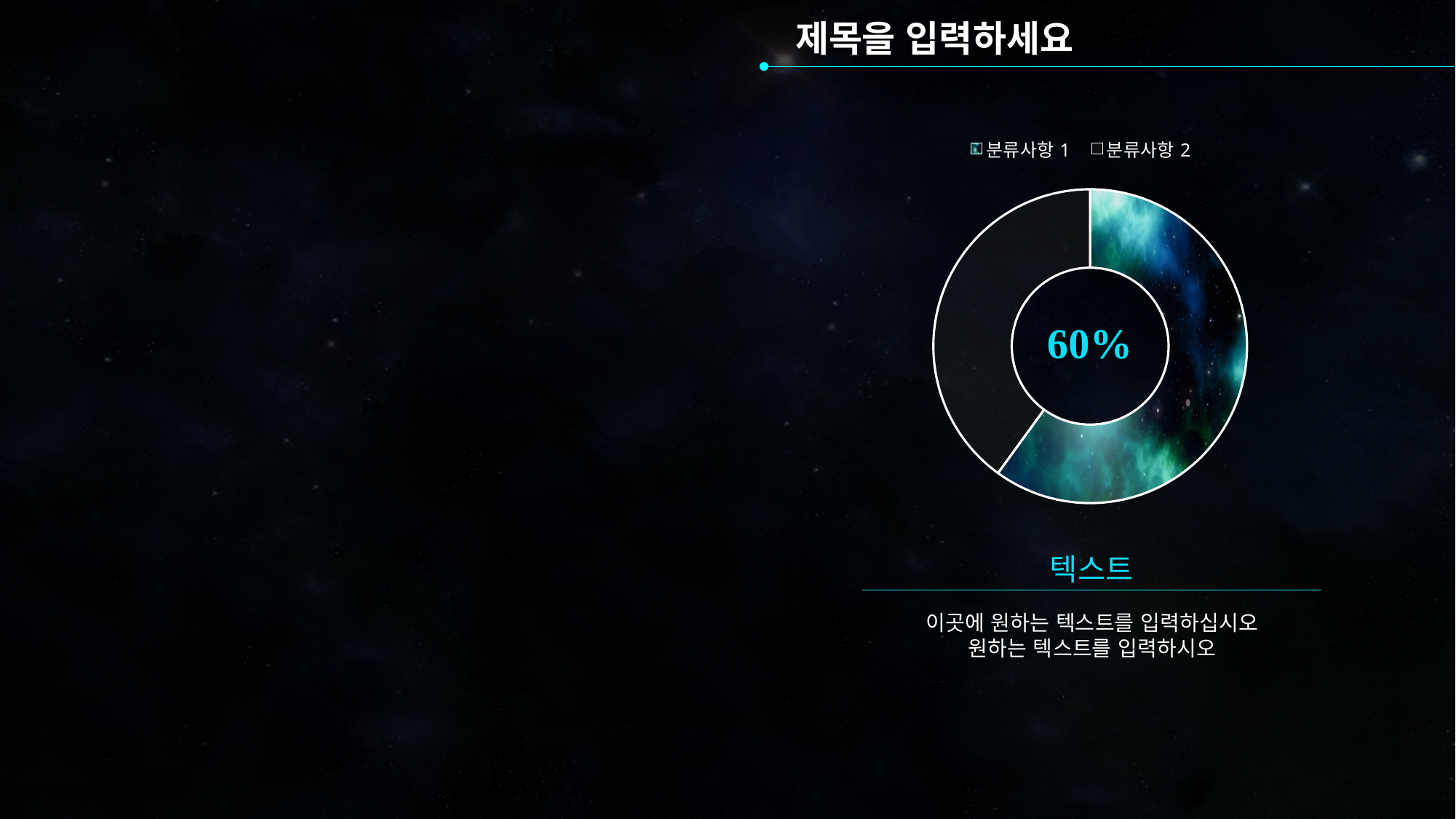
Is the share for 분류사항 2 greater or less than 50%? less How many entries does the chart legend list? 2 Is the share for 분류사항 1 greater or less than 50%? greater How many slices does the doughnut chart have? 2 Which legend entry is shown with the dark grey slice? 분류사항 2 Which slice is larger, 분류사항 1 or 분류사항 2? 분류사항 1 Which category takes up the smallest share of the doughnut chart? 분류사항 2 What kind of chart is shown on the slide? doughnut chart What percentage is printed in the centre of the doughnut chart? 60% Which category takes up the largest share of the doughnut chart? 분류사항 1 What share of the doughnut chart does 분류사항 1 represent? 60% What are the two legend entries of the chart? 분류사항 1 and 분류사항 2